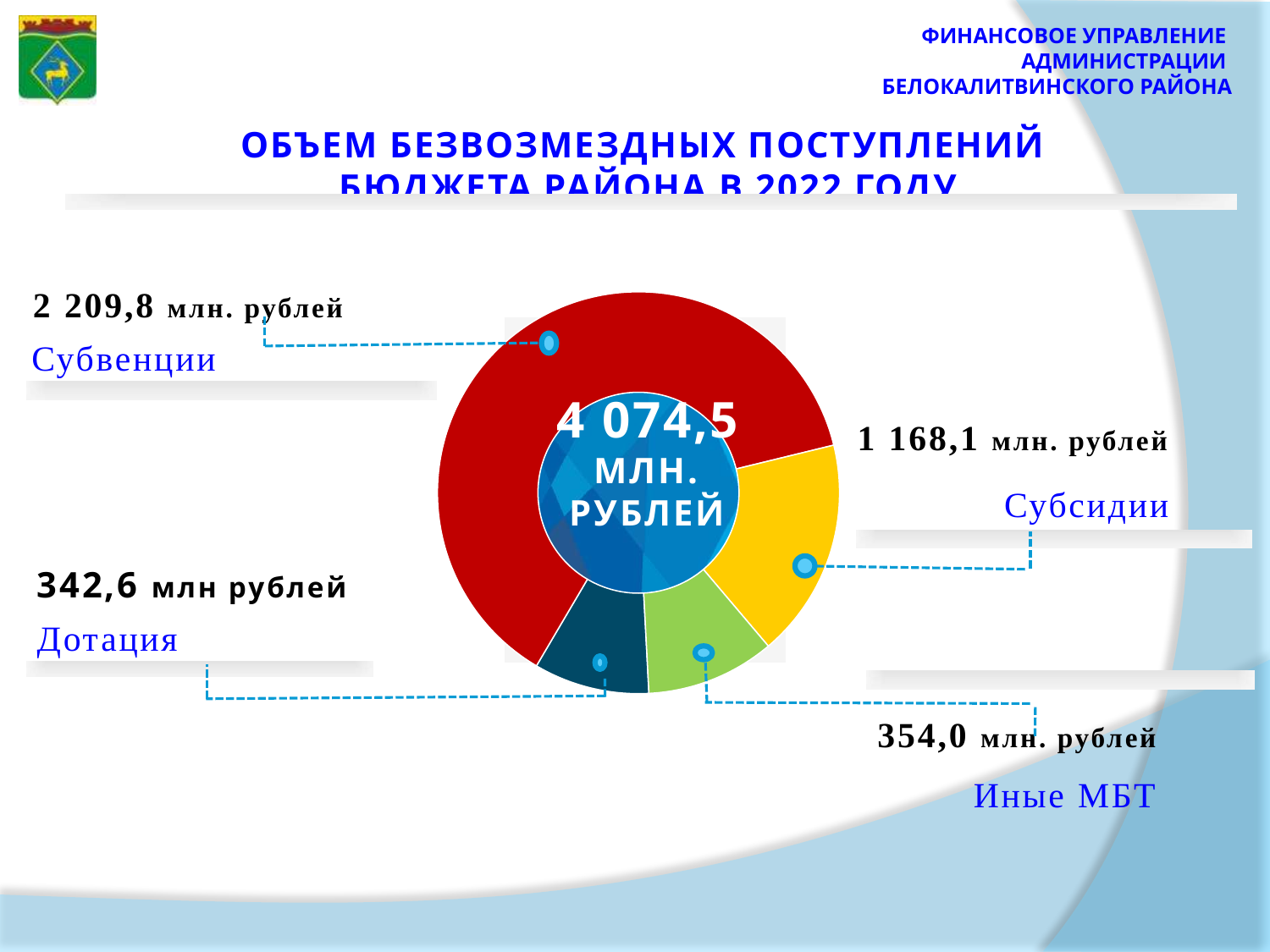
What is the value for Субвенции? 2 209,8 млн. рублей What is the value for Дотация? 342,6 млн рублей Which is larger, the value for Иные МБТ or the value for Дотация? Иные МБТ Which category has the smallest value? Дотация What colour is the slice for Субсидии? yellow Which category has the largest value? Субвенции What type of chart is shown on the slide? doughnut chart What is the total shown in the centre of the chart? 4 074,5 млн. рублей What is the difference between the values for Субвенции and Субсидии? 1 041,7 млн. рублей What is the value for Иные МБТ? 354,0 млн. рублей What is the value for Субсидии? 1 168,1 млн. рублей How many categories does the pie chart show? 4